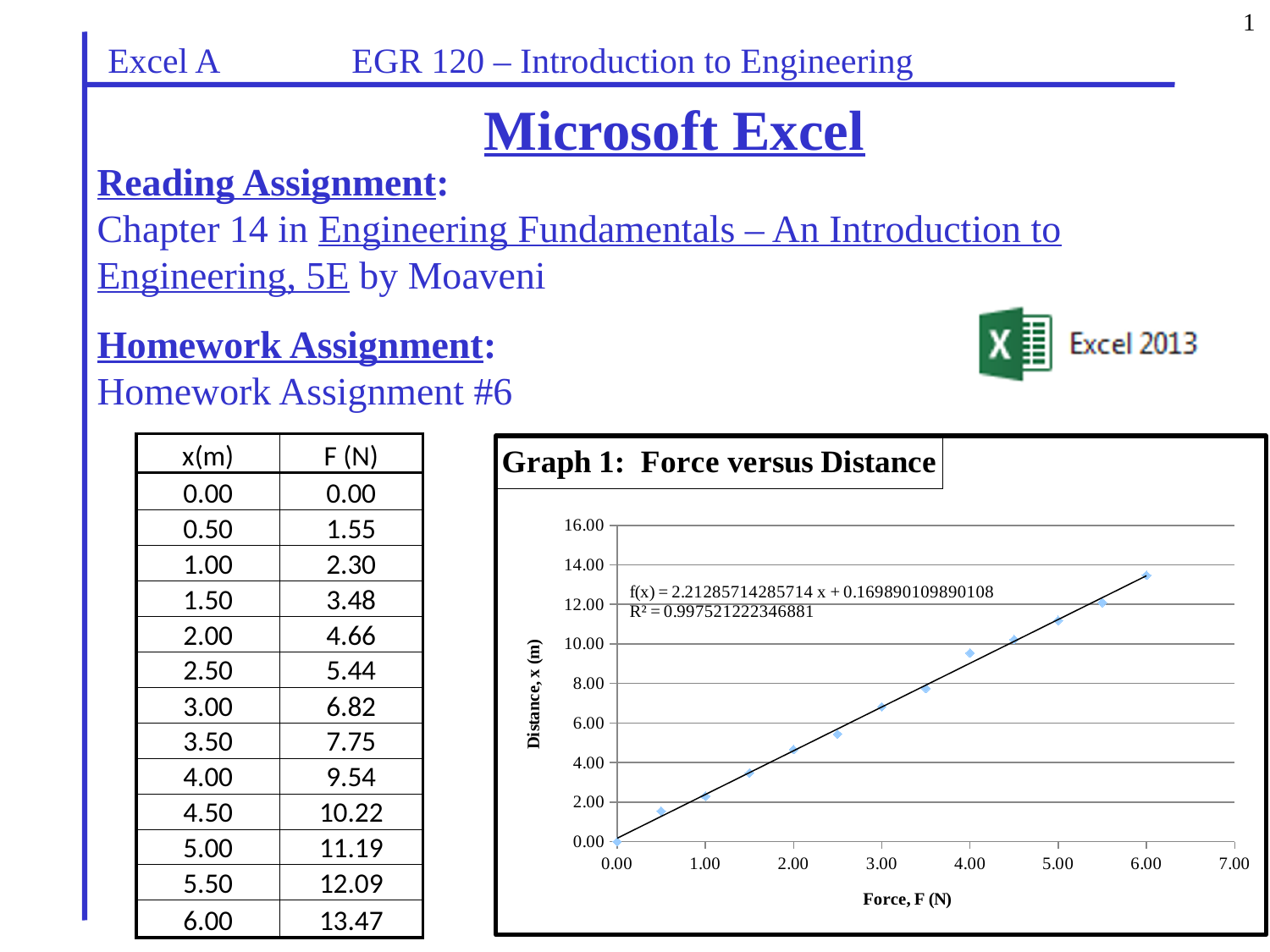
In Graph 1, at which x-axis value is the highest point plotted? 6.00 What kind of chart is Graph 1: Force versus Distance? scatter chart How many data points are plotted in Graph 1: Force versus Distance? 13 What is the title of the chart on the slide? Graph 1: Force versus Distance In Graph 1, do the plotted values rise or fall as the x-axis value increases? rise In Graph 1, what is the plotted value at an x-axis value of 6.00, as listed in the data table on the slide? 13.47 In Graph 1, is the plotted value at an x-axis value of 4.00 greater or less than 8.00? greater What is the x-axis label of Graph 1? Force, F (N) What is the slope of the trendline equation shown in Graph 1? 2.21285714285714 In Graph 1, is the plotted value at an x-axis value of 2.00 greater or less than 6.00? less What R² value is shown for the trendline in Graph 1? 0.997521222346881 What is the intercept of the trendline equation shown in Graph 1? 0.169890109890108